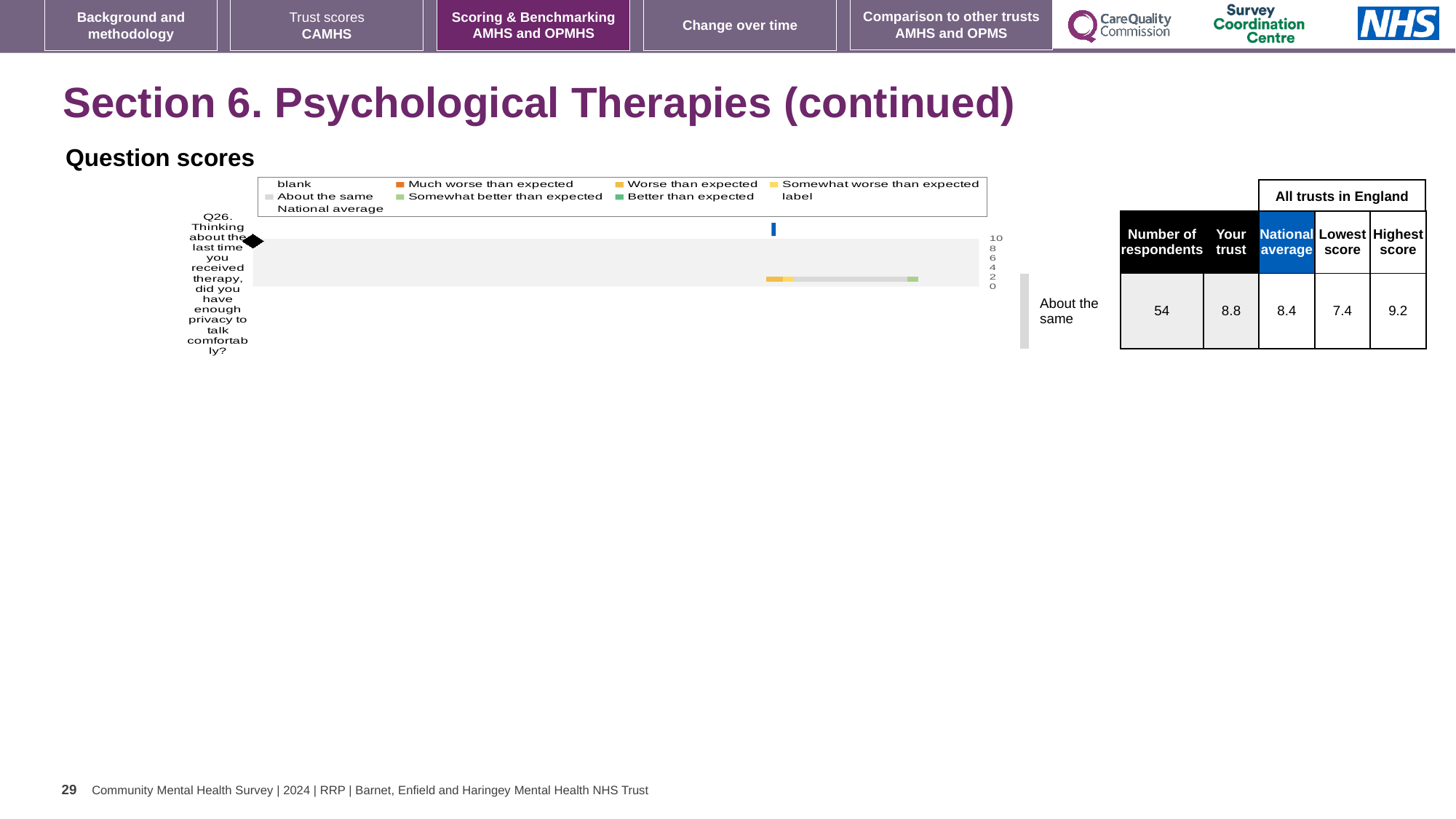
What is the maximum value shown on the chart's score axis? 10 In the table next to the chart, what is the highest score among all trusts in England for Q26? 9.2 For Q26, which is higher: the 'Your trust' score or the national average? Your trust For Q26, how much higher is the 'Your trust' score than the national average? 0.4 How many questions are plotted in the Question scores chart? 1 In the table next to the chart, what is the lowest score among all trusts in England for Q26? 7.4 What benchmark category is shown for Q26 next to the chart? About the same In the table next to the chart, what is the 'Your trust' score for Q26? 8.8 In the table next to the chart, what is the national average score for Q26? 8.4 What kind of chart is used to show the Q26 question score? bar chart How many respondents answered Q26 according to the table next to the chart? 54 For Q26, what is the difference between the highest score and the lowest score among all trusts in England? 1.8